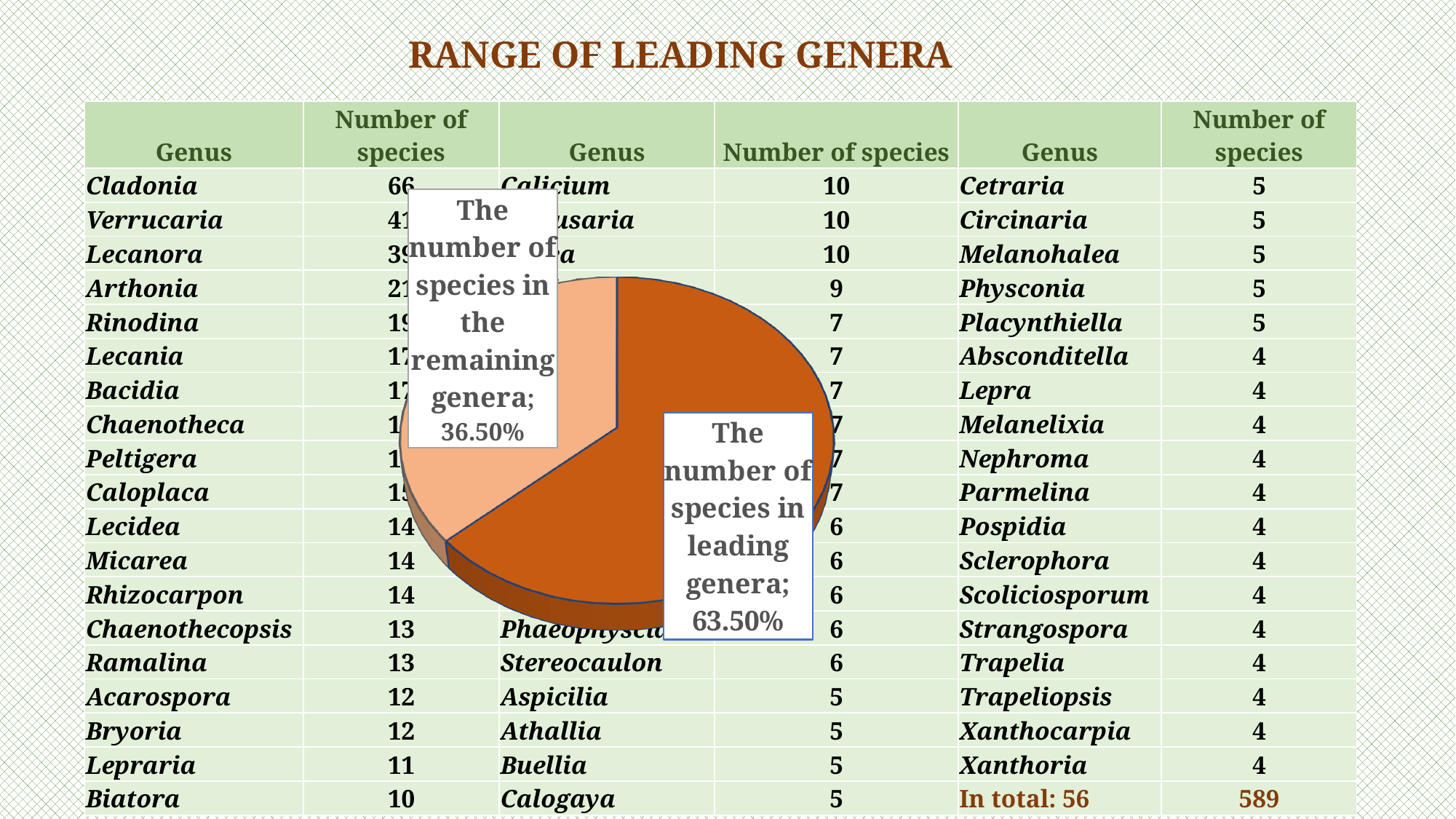
What share of the pie is labelled 'The number of species in the remaining genera'? 36.50% How many slices does the pie chart have? 2 What kind of chart is shown on the slide? pie chart Is the share for the remaining genera greater or less than 50%? less What share of the pie is labelled 'The number of species in leading genera'? 63.50% Which slice of the pie chart is the largest? The number of species in leading genera Is the share for leading genera greater or less than 60%? greater Which slice of the pie chart is the smallest? The number of species in the remaining genera What is the title of the slide containing the pie chart? RANGE OF LEADING GENERA Which is larger in the pie chart: the share for leading genera or the share for the remaining genera? leading genera What colour is the slice for the leading genera in the pie chart? dark orange What is the difference in percentage points between the leading genera slice and the remaining genera slice? 27 percentage points